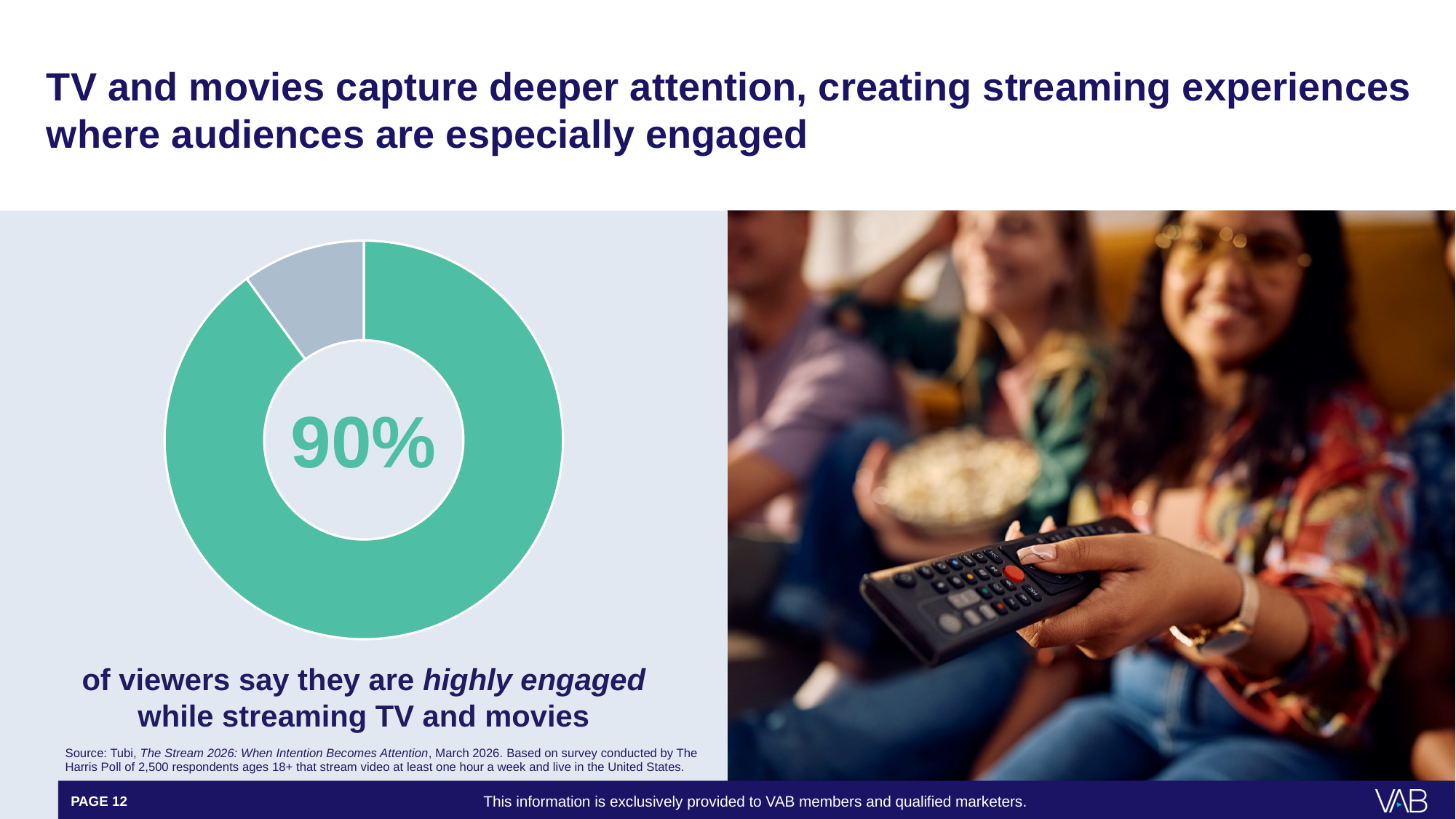
Which slice of the donut chart is larger, the green one or the grey one? The green one What share of the donut chart does the grey (non-highlighted) slice represent? 10% What percentage is printed in the center of the donut chart? 90% How many slices does the donut chart have? 2 What colour is the slice representing the 90% of highly engaged viewers? Green What share of viewers say they are highly engaged while streaming TV and movies, according to the chart? 90% What does the 90% in the donut chart represent, according to the caption below it? Viewers who say they are highly engaged while streaming TV and movies Is the highlighted share in the donut chart greater or less than 50%? greater What kind of chart is shown on the left side of the slide? Donut (pie) chart